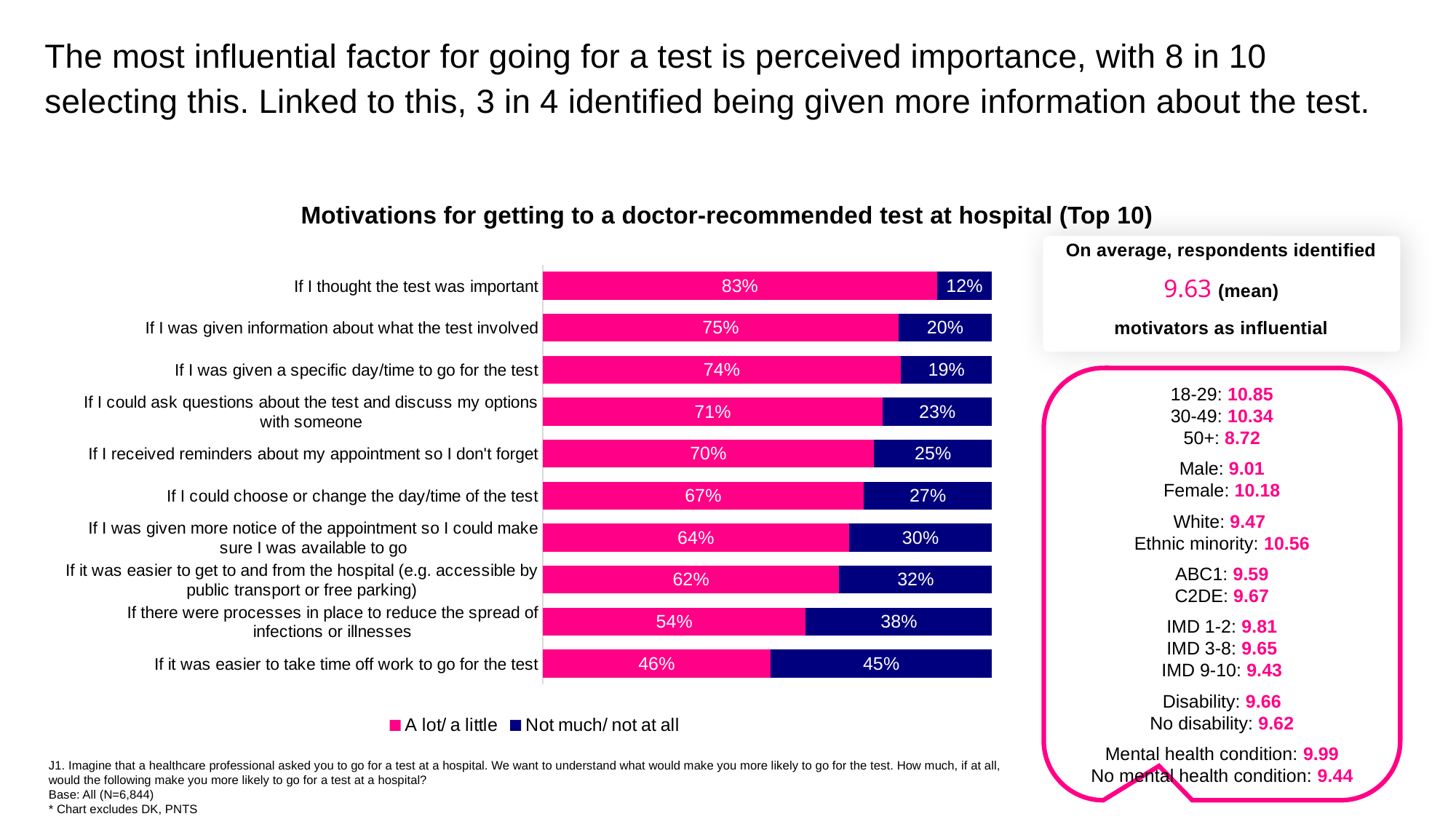
What is the total of the two segments for 'If I was given more notice of the appointment so I could make sure I was available to go'? 94% What is the 'A lot/ a little' value for 'If I received reminders about my appointment so I don't forget'? 70% Which has a larger 'Not much/ not at all' value: 'If there were processes in place to reduce the spread of infections or illnesses' or 'If I was given a specific day/time to go for the test'? If there were processes in place to reduce the spread of infections or illnesses What percentage of respondents said 'A lot/ a little' for 'If I thought the test was important'? 83% What type of chart is shown on the slide? Stacked bar chart What is the difference between the 'A lot/ a little' values for 'If I was given information about what the test involved' and 'If I could choose or change the day/time of the test'? 8% What is the 'Not much/ not at all' value for 'If it was easier to take time off work to go for the test'? 45% What is the title of the chart? Motivations for getting to a doctor-recommended test at hospital (Top 10) How many motivations are shown in the chart? 10 Which motivation has the highest 'A lot/ a little' percentage? If I thought the test was important How many series does the legend list? 2 Which motivation has the lowest 'A lot/ a little' percentage? If it was easier to take time off work to go for the test